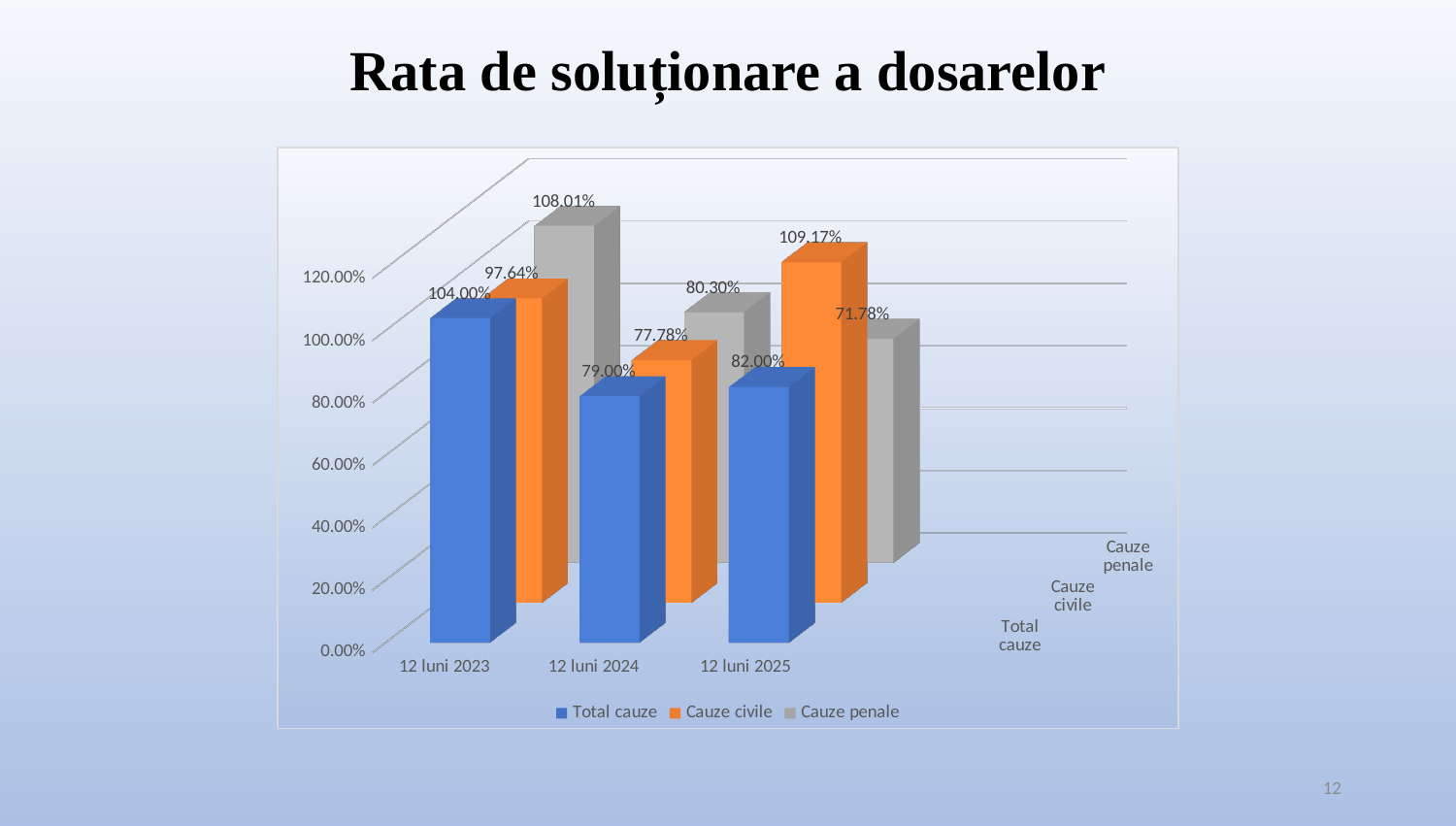
How many series does the legend list? 3 Which is larger for 12 luni 2025: Cauze civile or Cauze penale? Cauze civile What is the value of Cauze civile for 12 luni 2024? 77.78% What is the difference between Cauze penale for 12 luni 2023 and 12 luni 2025? 36.23% Which period has the highest value for Cauze penale? 12 luni 2023 What is the value of Cauze penale for 12 luni 2024? 80.30% What is the title of the chart? Rata de soluționare a dosarelor How many periods are shown on the x axis? 3 Which period has the lowest value for Total cauze? 12 luni 2024 What is the value of Cauze civile for 12 luni 2025? 109.17% What kind of chart is shown on the slide? Bar chart What is the value of Total cauze for 12 luni 2023? 104.00%